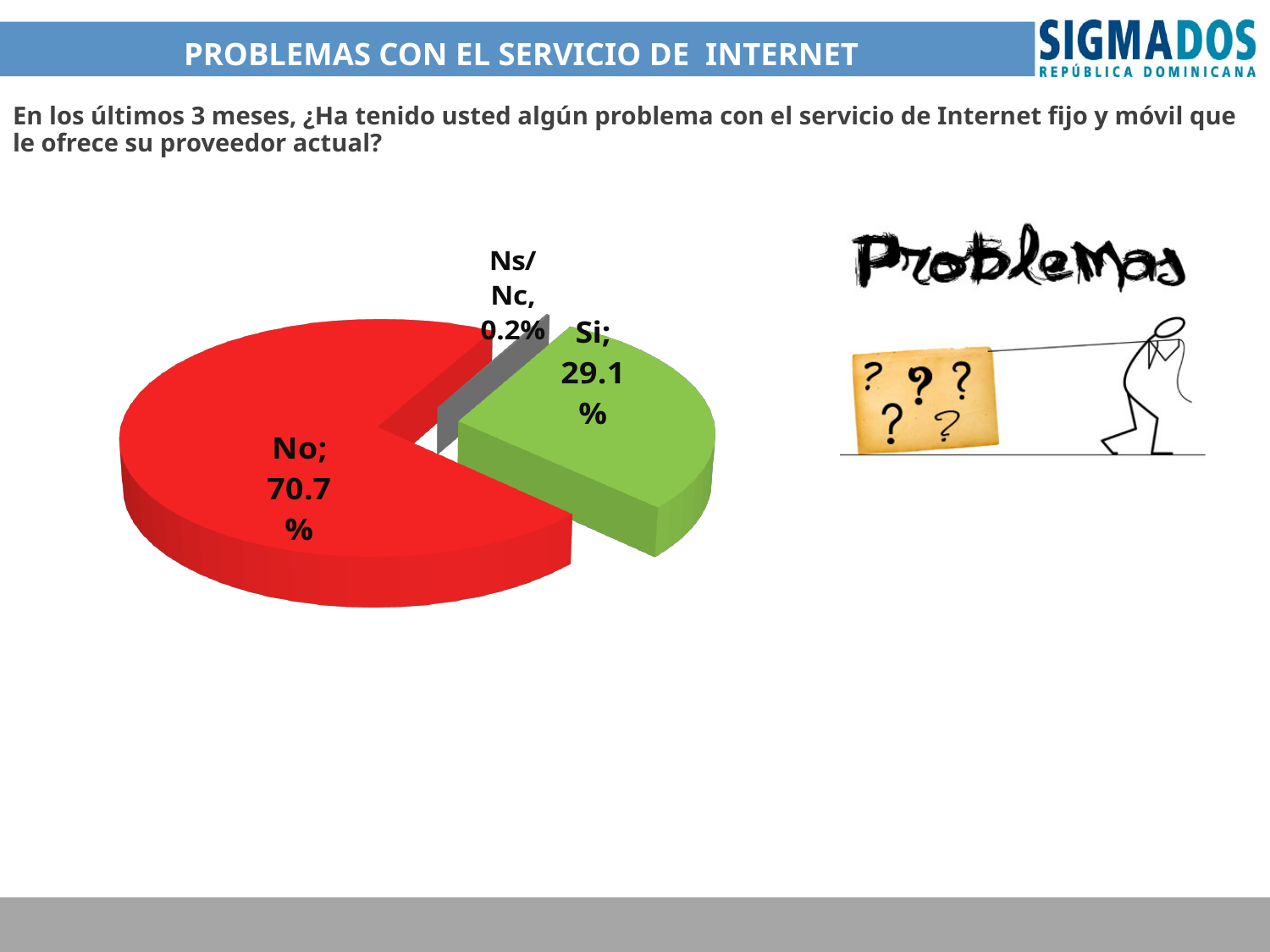
What kind of chart is shown on the slide? pie chart Which is larger, the share for "Si" or the share for "No"? No What is the difference in percentage points between "No" and "Si"? 41.6 How many slices does the pie chart have? 3 What percentage of respondents answered "Si"? 29.1% Which category has the smallest slice of the pie? Ns/Nc What percentage is shown for "Ns/Nc"? 0.2% What colour is the "No" slice? red What colour is the "Si" slice? green What share of the pie does the "Si" slice represent? 29.1% Which category has the largest slice of the pie? No What percentage of respondents answered "No"? 70.7%